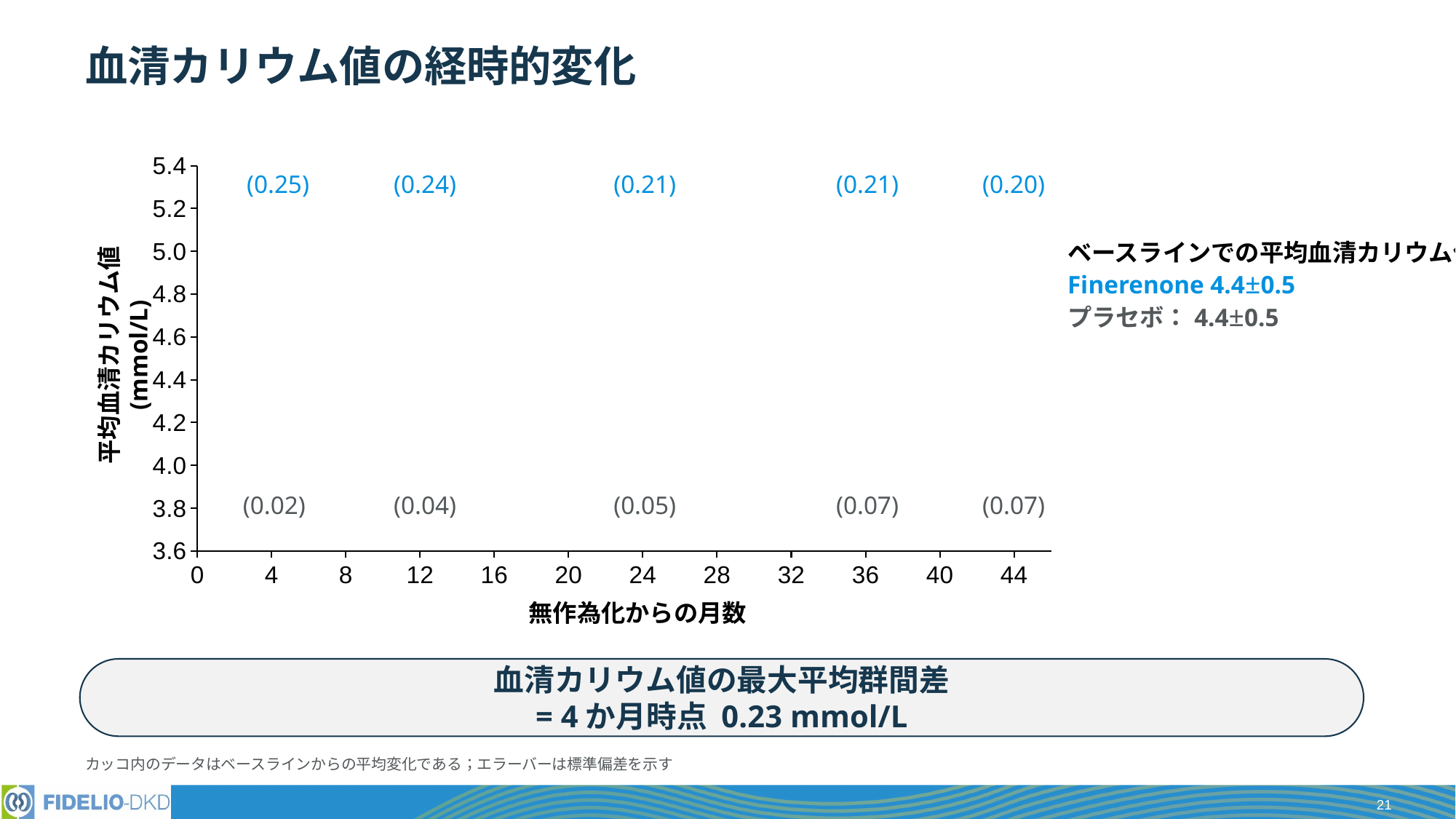
What is the gray annotated mean change from baseline at 24 months? 0.05 How many time points carry annotated mean-change values in the chart? 5 What is the blue annotated mean change from baseline at 44 months? 0.20 What is the y-axis title of the chart? 平均血清カリウム値 (mmol/L) What is the x-axis title of the chart? 無作為化からの月数 Do the blue annotated mean-change values rise or fall from 4 months to 44 months? fall What is the difference between the blue and gray annotated mean changes at 4 months? 0.23 What is the gray annotated mean change from baseline at 4 months? 0.02 At which month is the blue annotated mean change from baseline the highest? 4 What is the blue annotated mean change from baseline at 4 months? 0.25 Do the gray annotated mean-change values rise or fall from 4 months to 44 months? rise At which month is the gray annotated mean change from baseline the lowest? 4